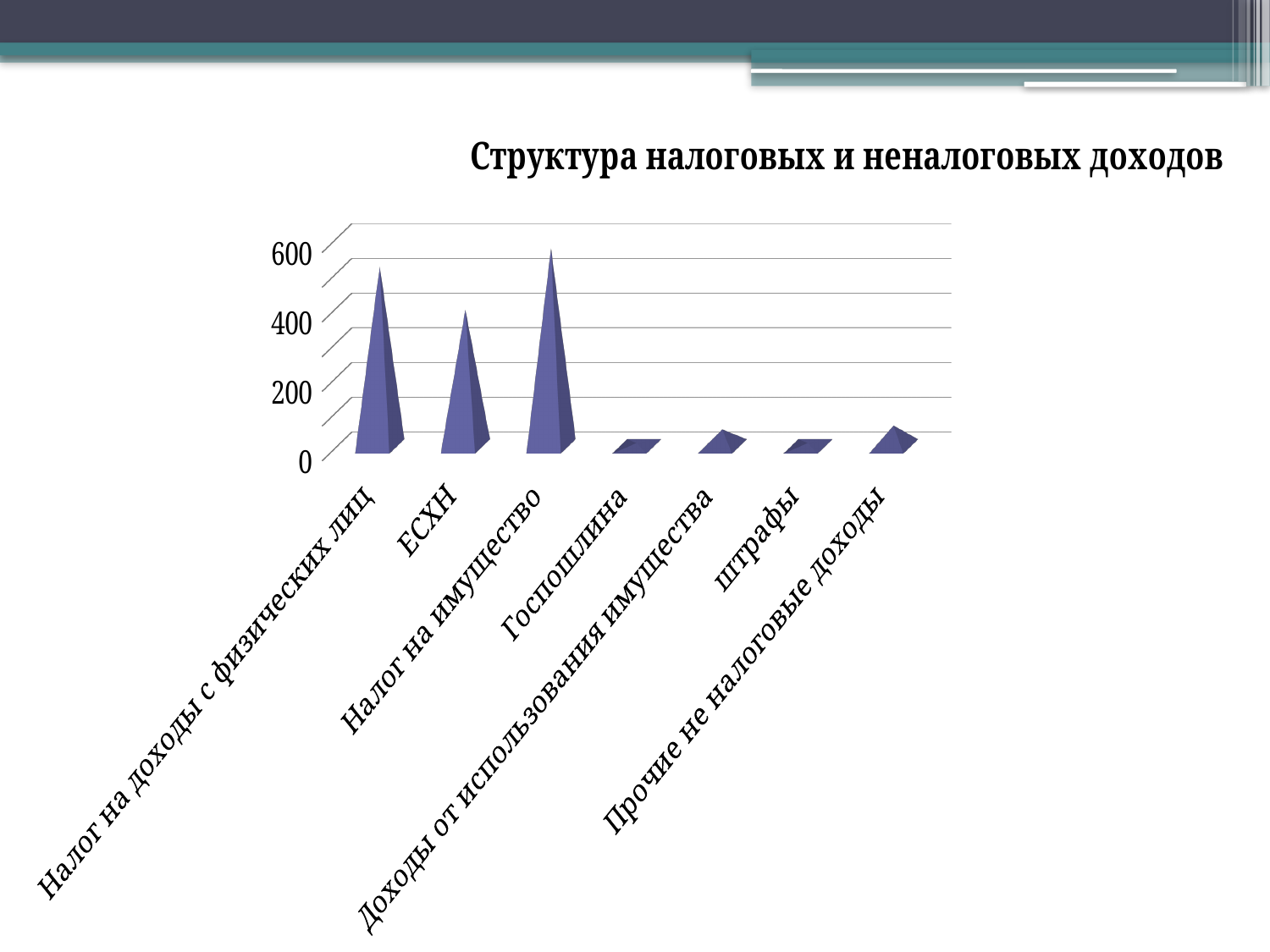
Is the value for Налог на доходы с физических лиц greater or less than 400? greater What kind of chart is shown on the slide? Bar chart How many categories are shown on the x axis of the chart? 7 Is the value for Налог на имущество greater or less than 400? greater What is the highest value labelled on the vertical axis of the chart? 600 Which category has the highest value in the chart? Налог на имущество Which is larger, the value for Налог на имущество or the value for штрафы? Налог на имущество Is the value for Прочие не налоговые доходы greater or less than 200? less Which is larger, the value for Налог на доходы с физических лиц or the value for ЕСХН? Налог на доходы с физических лиц What is the title of the chart? Структура налоговых и неналоговых доходов